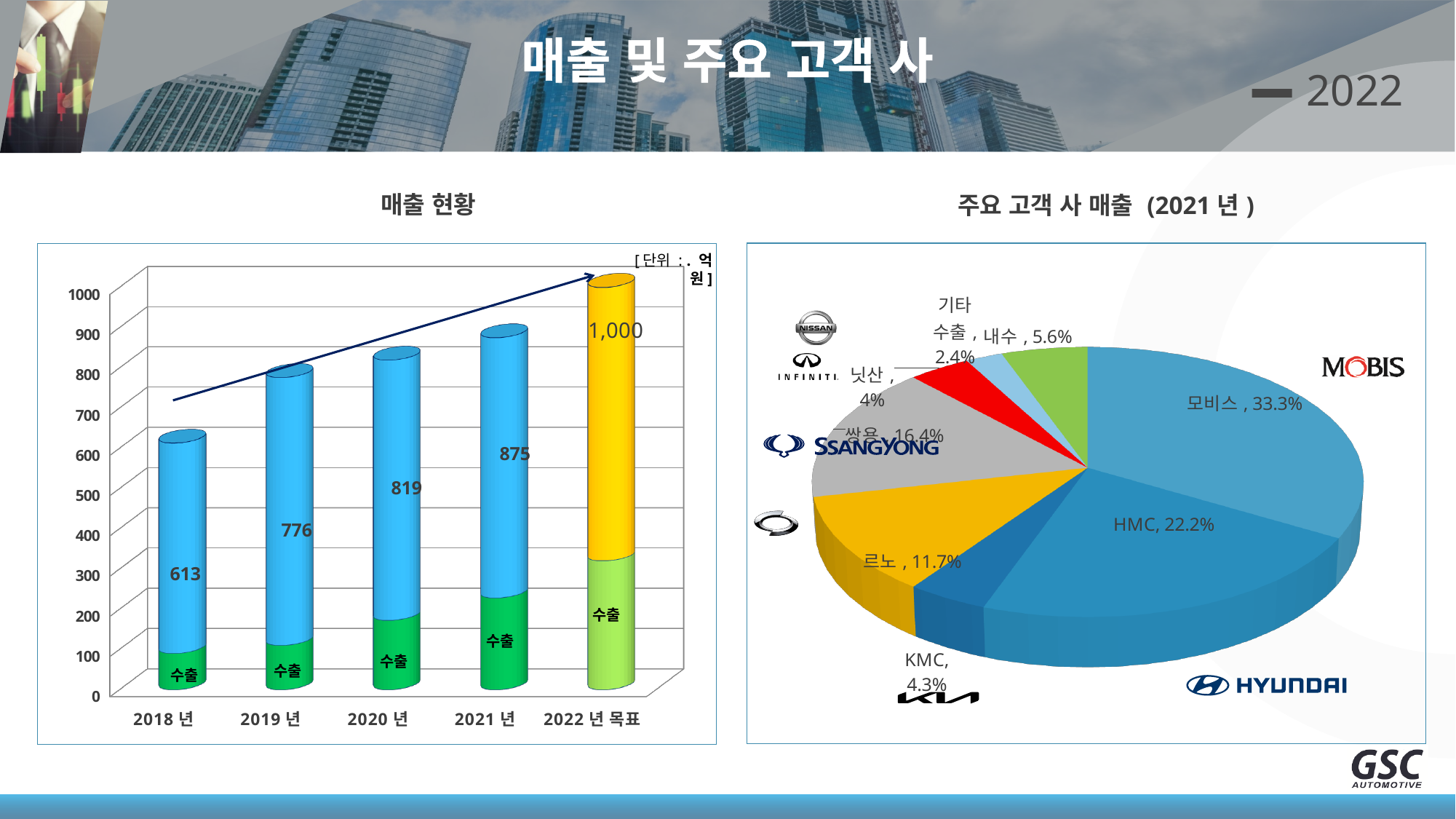
In the 매출 현황 chart, what is the value for 2019 년? 776 What kind of chart is the 매출 현황 chart? bar chart In the 주요 고객 사 매출 (2021 년) chart, which customer has the largest share? 모비스 In the 매출 현황 chart, what is the value for 2022 년 목표? 1,000 What kind of chart is the 주요 고객 사 매출 (2021 년) chart? pie chart In the 주요 고객 사 매출 (2021 년) chart, what share does 모비스 have? 33.3% In the 매출 현황 chart, do the values rise or fall from 2018 년 to 2022 년 목표? rise In the 주요 고객 사 매출 (2021 년) chart, which is larger, 쌍용 or 르노? 쌍용 In the 매출 현황 chart, which year has the lowest value? 2018 년 In the 매출 현황 chart, what is the difference between the 2021 년 value and the 2018 년 value? 262 In the 매출 현황 chart, how many bars are plotted? 5 In the 매출 현황 chart, what is the value for 2021 년? 875